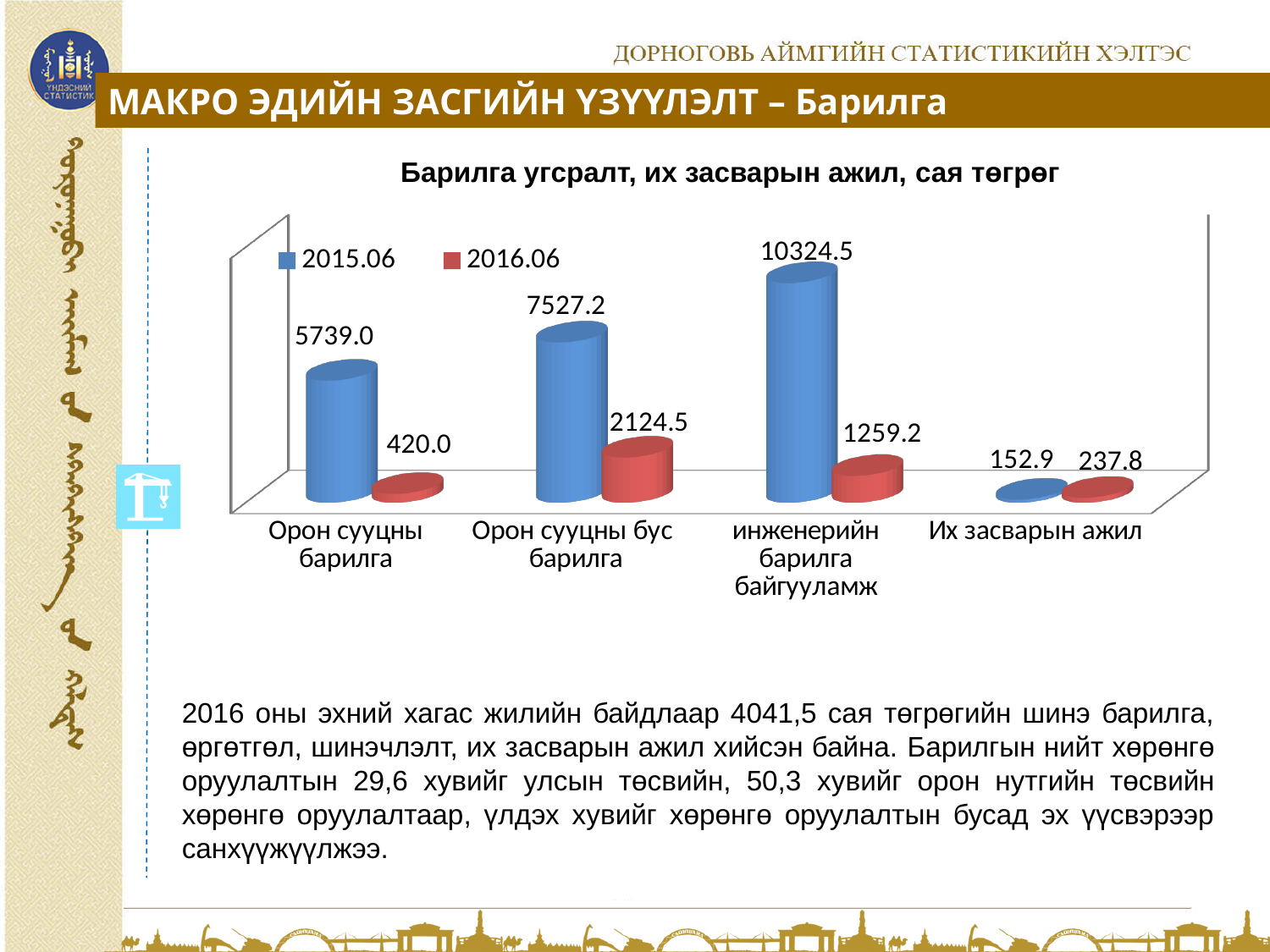
What is the value for 2015.06 for инженерийн барилга байгууламж? 10324.5 What is the title of the chart? Барилга угсралт, их засварын ажил, сая төгрөг What kind of chart is shown on the slide? bar chart For Их засварын ажил, which is larger: the 2015.06 value or the 2016.06 value? 2016.06 Which category has the lowest value for 2016.06? Их засварын ажил How many categories are shown on the x axis? 4 What is the value for 2016.06 for Их засварын ажил? 237.8 What is the value for 2016.06 for Орон сууцны бус барилга? 2124.5 What is the value for 2015.06 for Орон сууцны барилга? 5739.0 Which category has the highest value for 2015.06? инженерийн барилга байгууламж What is the difference between the 2015.06 and 2016.06 values for Орон сууцны барилга? 5319.0 How many series does the legend list? 2